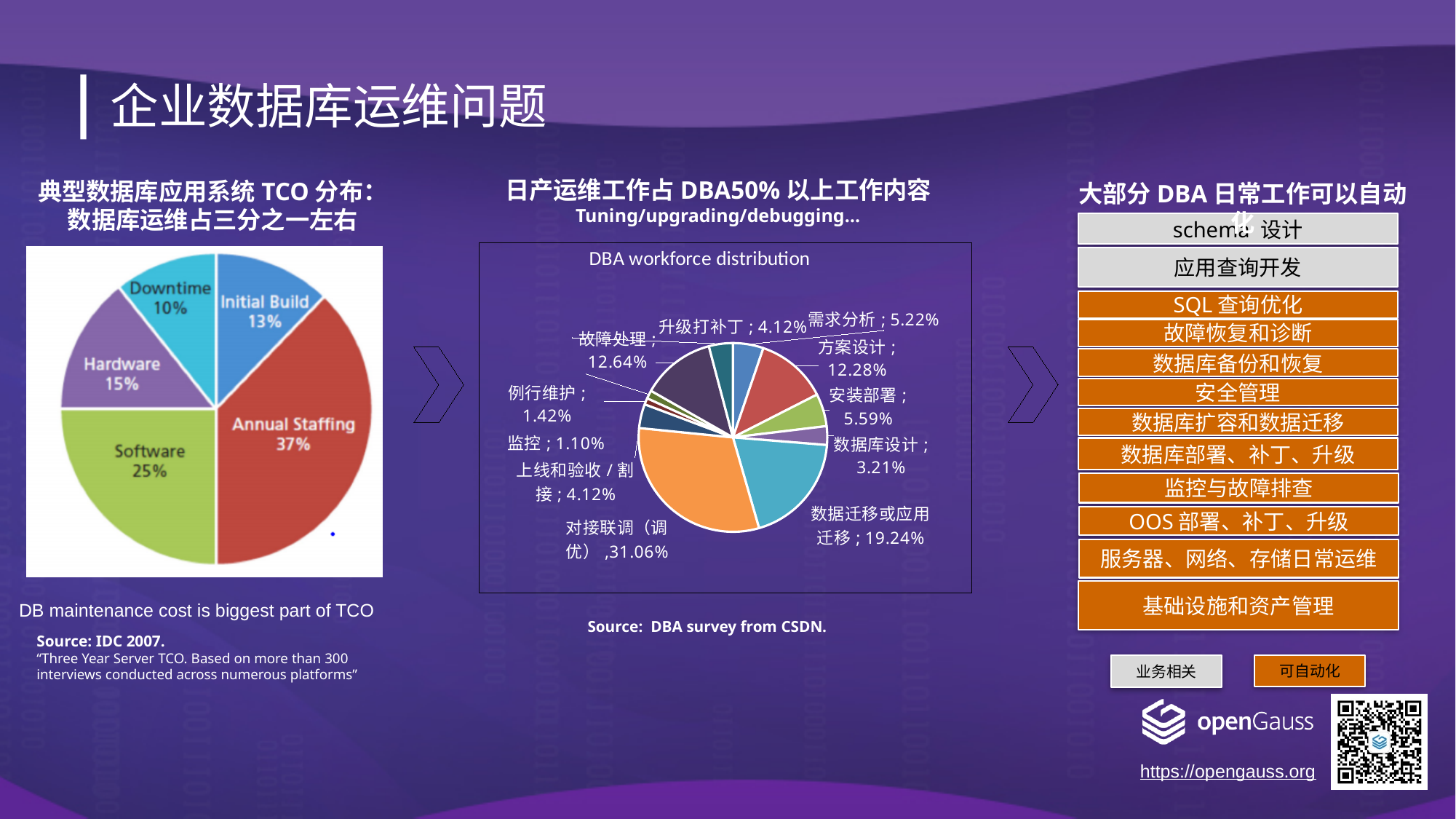
What type of chart is the DBA workforce distribution chart? Pie chart In the DBA workforce distribution chart, how many categories are shown? 11 In the DBA workforce distribution chart, what percentage is 对接联调（调优）? 31.06% In the left pie chart (TCO distribution), what percentage is Annual Staffing? 37% In the DBA workforce distribution chart, what percentage is 数据迁移或应用迁移? 19.24% In the left pie chart (TCO distribution), which category has the smallest share? Downtime In the left pie chart (TCO distribution), what percentage is Hardware? 15% In the left pie chart (TCO distribution), how many categories are shown? 5 In the DBA workforce distribution chart, which is larger, 故障处理 or 方案设计? 故障处理 In the left pie chart (TCO distribution), what is the difference between Software and Initial Build? 12% In the DBA workforce distribution chart, which category has the smallest share? 监控 In the left pie chart (TCO distribution), which category has the largest share? Annual Staffing